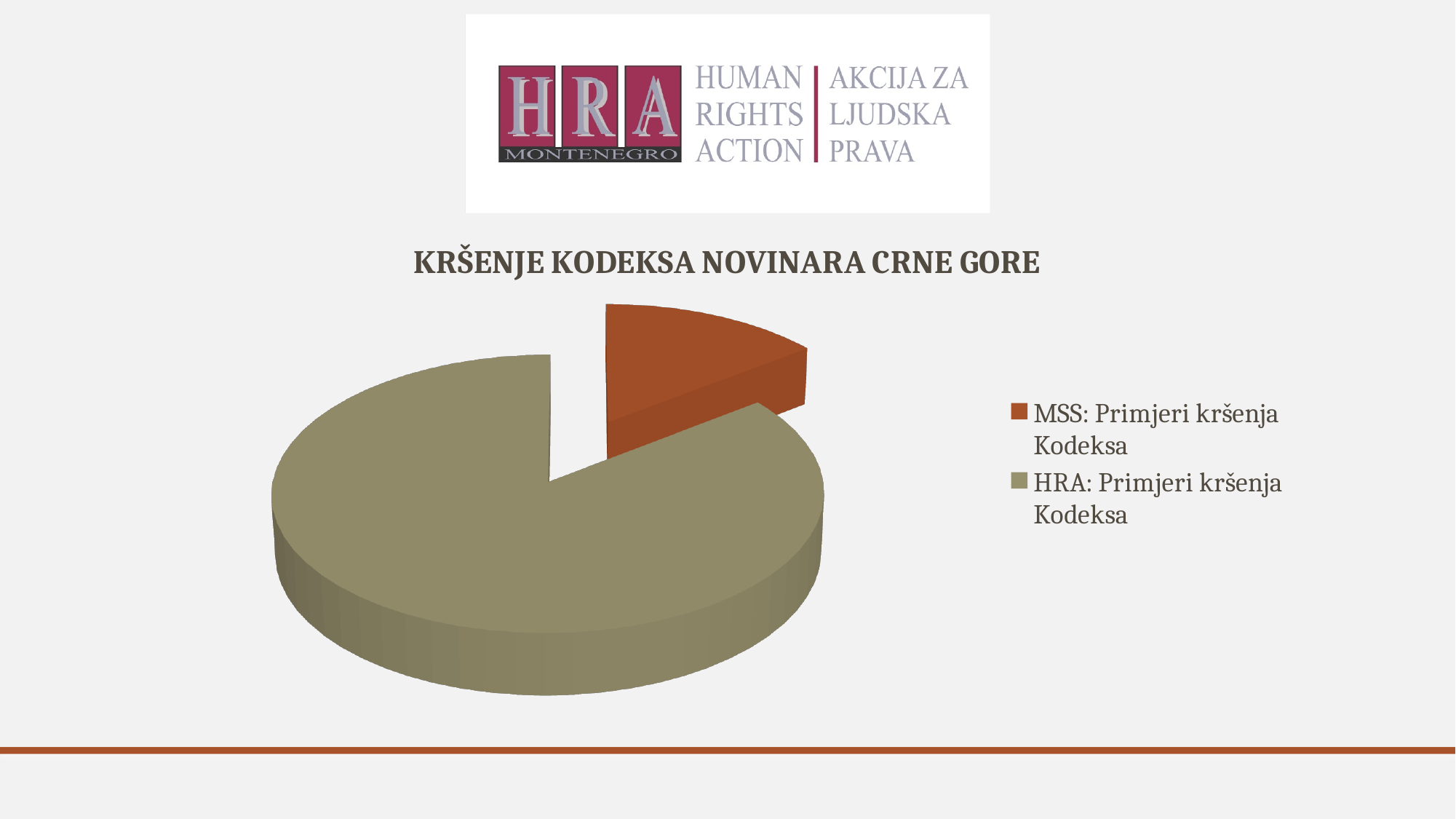
What kind of chart is shown on the slide? pie chart How many entries does the legend list? 2 Which slice is larger, MSS: Primjeri kršenja Kodeksa or HRA: Primjeri kršenja Kodeksa? HRA: Primjeri kršenja Kodeksa How many slices does the pie chart have? 2 Which legend entry is shown in orange-brown colour? MSS: Primjeri kršenja Kodeksa Which slice is the smallest in the pie chart? MSS: Primjeri kršenja Kodeksa Which slice is the largest in the pie chart? HRA: Primjeri kršenja Kodeksa What is the title of the chart? KRŠENJE KODEKSA NOVINARA CRNE GORE